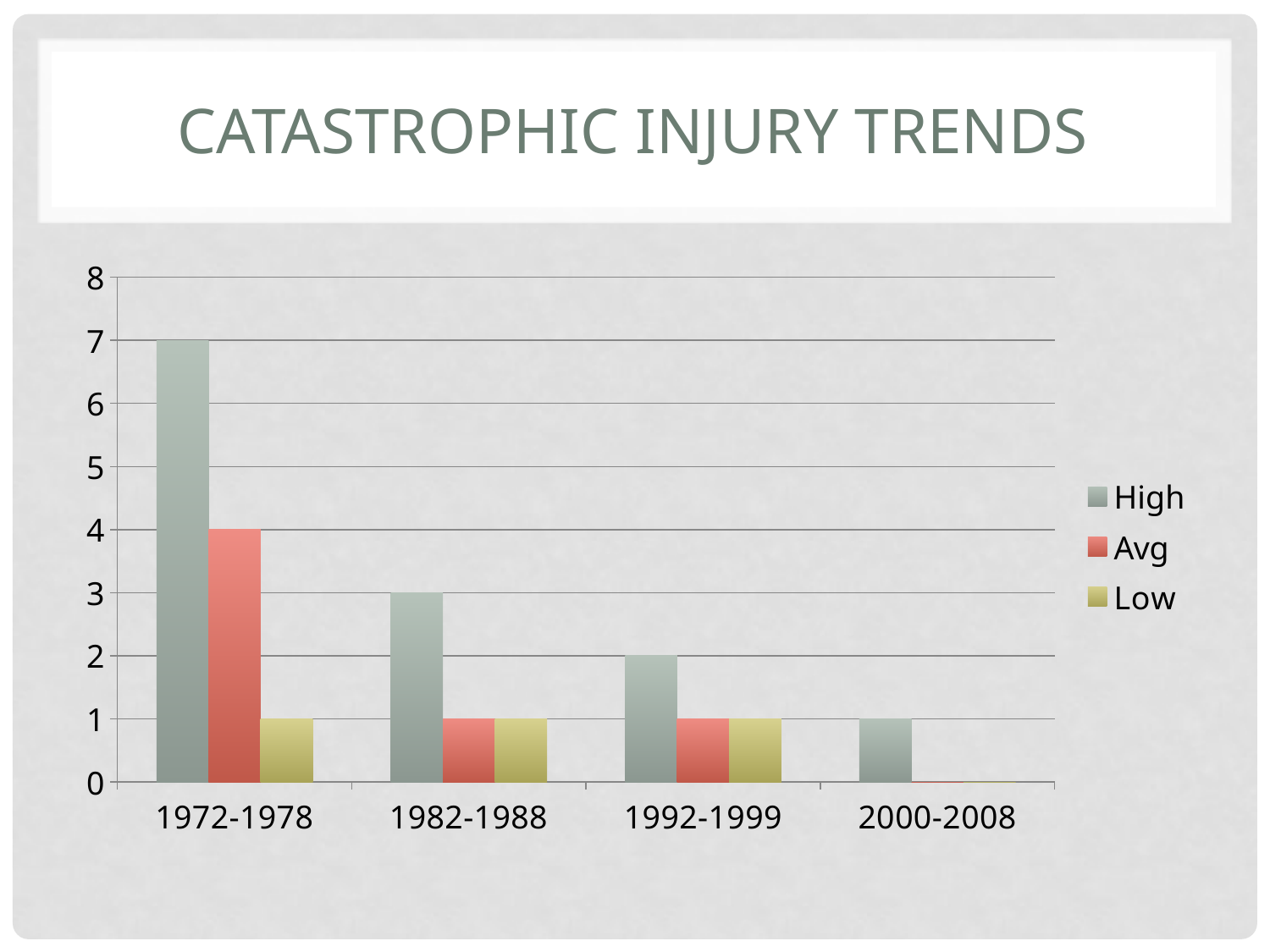
What kind of chart is shown on the slide? bar chart How many series does the legend list? 3 Which period has the lowest High value? 2000-2008 What is the High value for 1982-1988? 3 What is the High value for 1972-1978? 7 What is the difference between the High value for 1972-1978 and the High value for 1992-1999? 5 Which period has the highest High value? 1972-1978 How many time periods are shown on the x axis? 4 Is the Avg value for 1972-1978 larger or smaller than the Avg value for 1982-1988? larger Do the High values rise or fall from 1972-1978 to 2000-2008? fall What is the Avg value for 1972-1978? 4 What is the title of the chart? Catastrophic Injury Trends